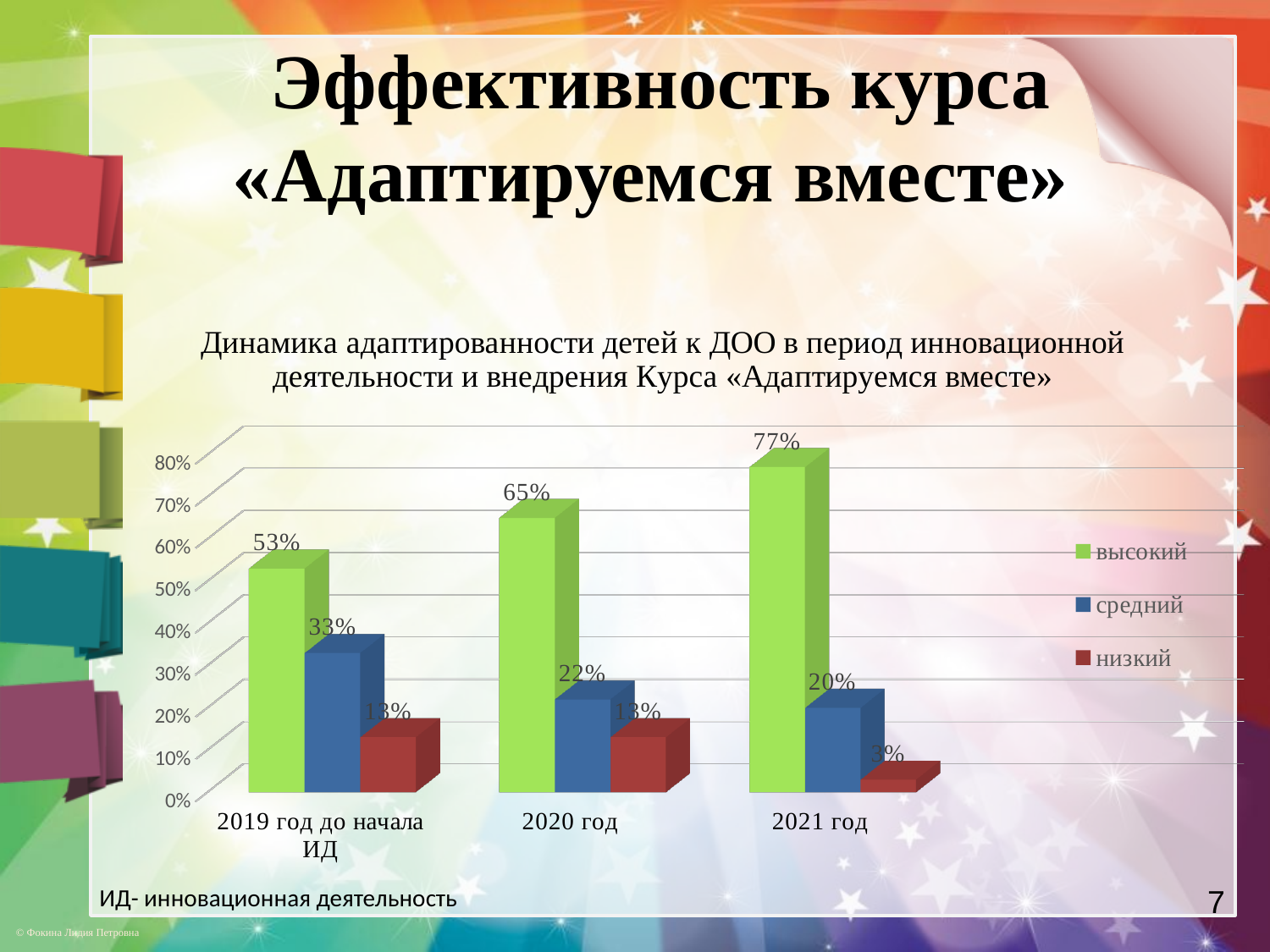
What is the value for «средний» in 2019 год до начала ИД? 33% What is the value for «низкий» in 2021 год? 3% In which year is the «высокий» value the highest? 2021 год How many series does the legend list? 3 Which is larger: the «средний» value in 2020 год or in 2021 год? 2020 год Does the «высокий» value rise or fall from 2019 to 2021? rise What kind of chart is shown on the slide? bar chart In which year is the «низкий» value the lowest? 2021 год What is the value for «высокий» in 2021 год? 77% What is the value for «высокий» in 2020 год? 65% How many year categories are shown on the x axis? 3 What is the difference between the «высокий» values for 2021 год and 2019 год до начала ИД? 24%